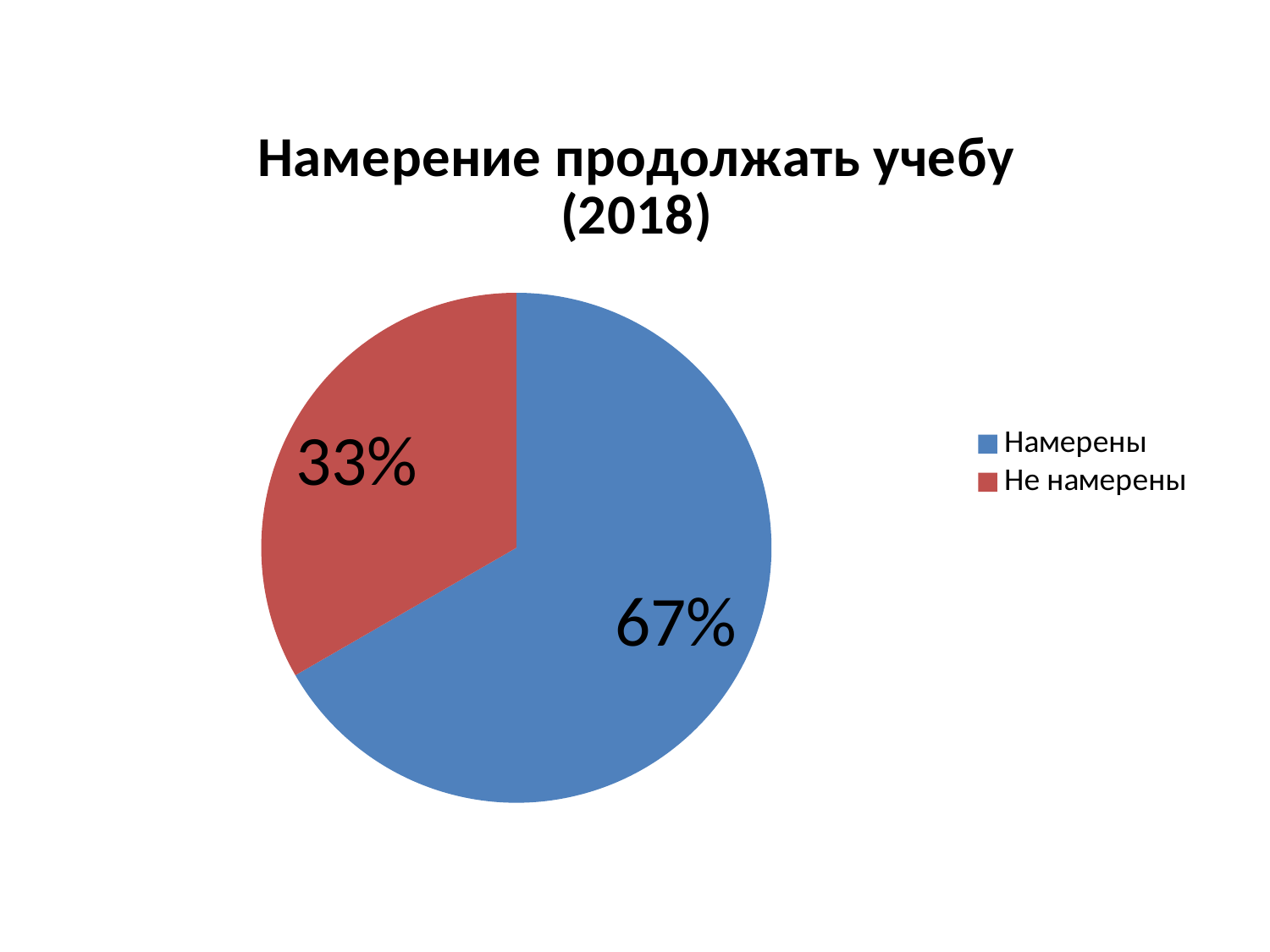
What is the difference in percentage points between the "Намерены" and "Не намерены" slices? 34 What share of the pie is labelled "Намерены"? 67% Which is larger, the "Намерены" slice or the "Не намерены" slice? Намерены Which slice is the smallest? Не намерены What share of the pie is labelled "Не намерены"? 33% How many slices does the pie chart have? 2 What kind of chart is shown on the slide? pie chart Is the share for "Намерены" greater or less than 50%? greater How many entries does the legend list? 2 Which slice is the largest? Намерены What is the title of the chart? Намерение продолжать учебу (2018) What colour is the "Не намерены" slice? red